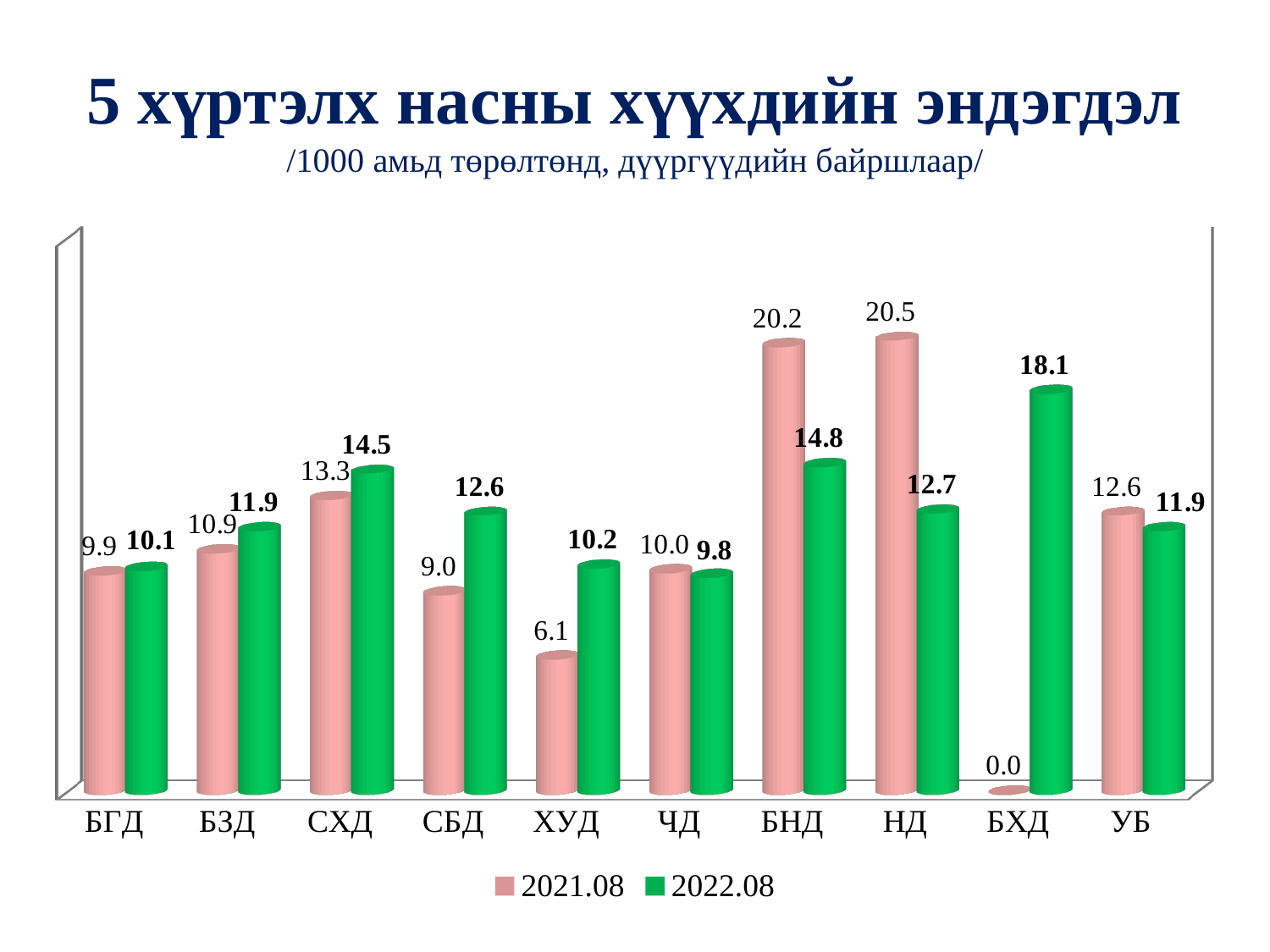
What is the difference between the 2021.08 and 2022.08 values for НД? 7.8 What is the value for БХД in the 2022.08 series? 18.1 What is the value for ХУД in the 2021.08 series? 6.1 How many series does the legend list? 2 How many districts (categories) are shown on the x axis? 10 What is the value for БНД in the 2021.08 series? 20.2 Which district has the highest value in the 2022.08 series? БХД Which district has the lowest value in the 2022.08 series? ЧД What kind of chart is shown on the slide? Bar chart Which district has the highest value in the 2021.08 series? НД What is the difference between the 2022.08 and 2021.08 values for СБД? 3.6 For БНД, which is larger: the 2021.08 value or the 2022.08 value? 2021.08